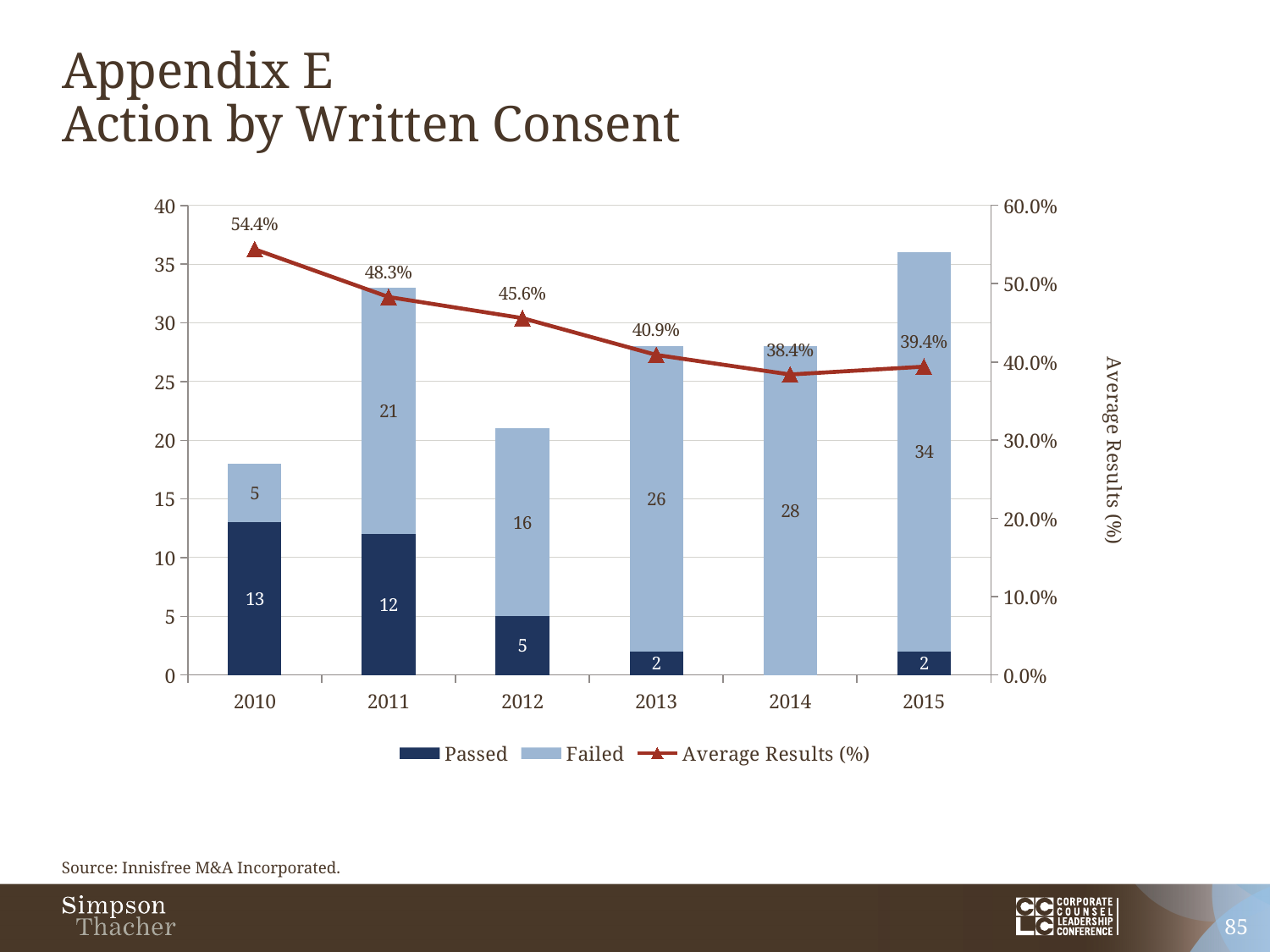
Is the Passed value larger in 2010 or in 2012? 2010 What is the Failed value for 2013? 26 Does the Average Results (%) line generally rise or fall from 2010 to 2014? fall Which year has the highest Failed value? 2015 What is the difference between the Failed values for 2015 and 2010? 29 How many years are shown on the x axis? 6 What is the Passed value for 2011? 12 What is the Average Results (%) value for 2012? 45.6% Which year has the lowest Average Results (%)? 2014 Which year has the highest Average Results (%)? 2010 How many series does the legend list? 3 What is the total of the stacked bar for 2011? 33